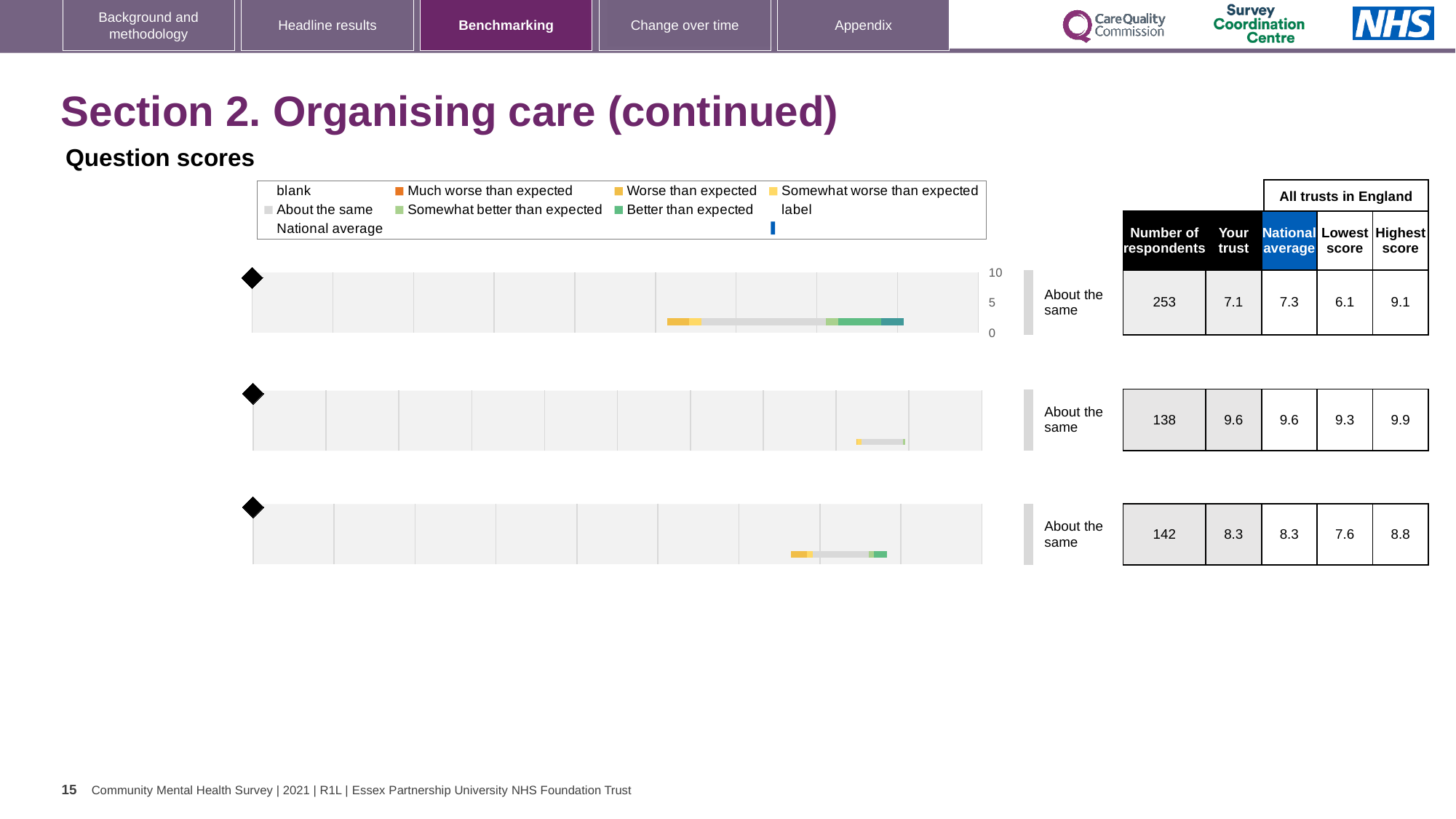
For the top chart, what is the 'Your trust' score in the table? 7.1 Which colour in the legend represents 'Much worse than expected'? orange How many question-score charts are shown on the slide? 3 What is the highest value shown on the vertical axis of the top chart? 10 For the bottom chart, what is the 'Highest score' in the table? 8.8 What benchmark category is shown next to the bottom chart? About the same For the top chart, what is the difference between the 'Highest score' and the 'Lowest score' in the table? 3.0 What benchmark category is shown next to the top chart? About the same For the middle chart, what is the 'Number of respondents' in the table? 138 For the middle chart, is the 'Your trust' score greater or less than the 'National average'? neither, they are equal (9.6) Which chart has the higher 'Your trust' score in its table, the top chart or the middle chart? the middle chart What kind of chart is used to show the question scores on this slide? bar chart